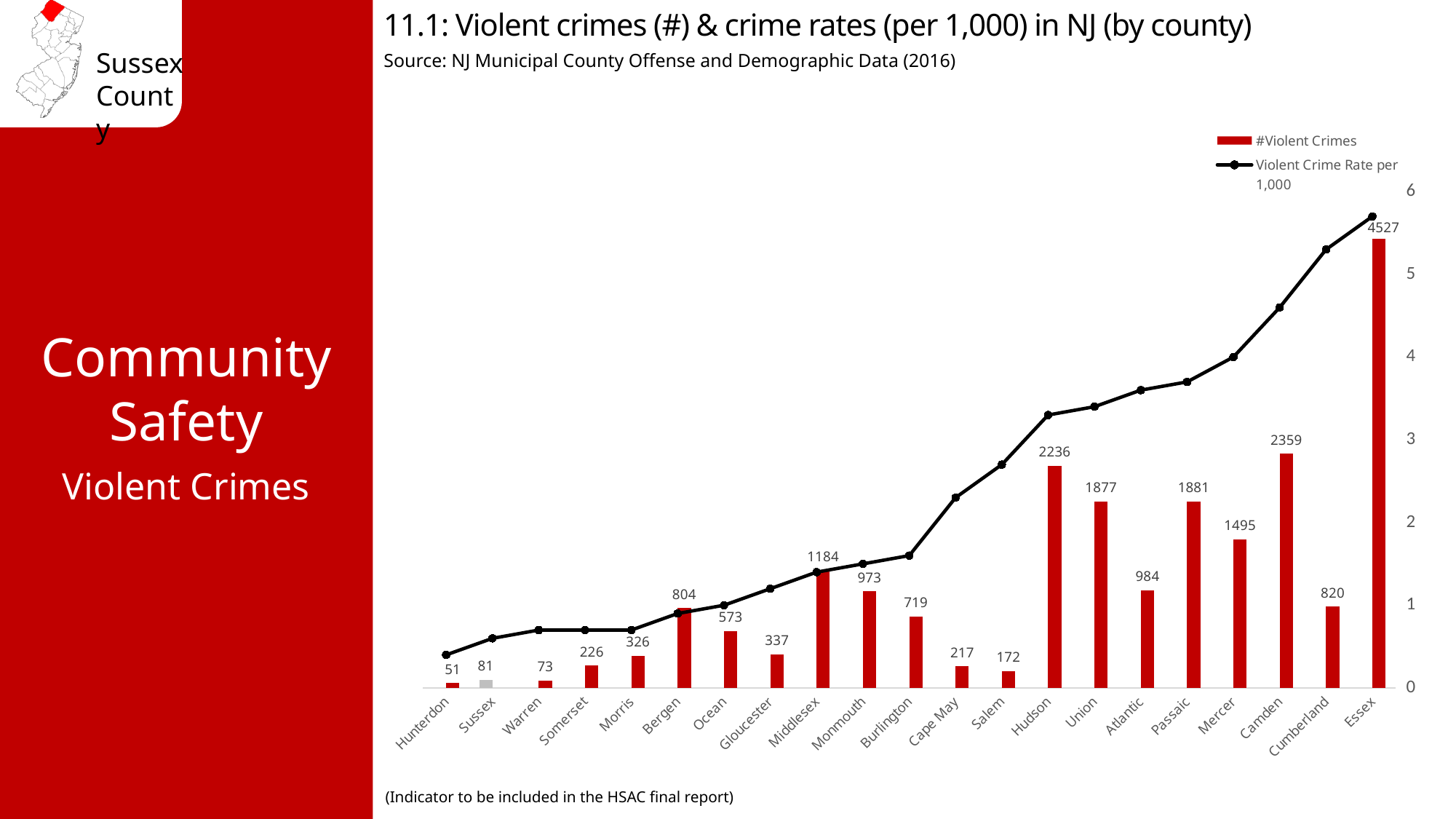
How many series does the legend list? 2 What is the number of violent crimes for Essex? 4527 Which county has more violent crimes, Monmouth or Burlington? Monmouth Which county has the lowest number of violent crimes? Hunterdon What is the number of violent crimes for Sussex? 81 Does the violent crime rate per 1,000 line rise or fall from left to right across the counties? rises How many counties are shown on the x axis? 21 Is the violent crime rate per 1,000 for Hunterdon greater or less than 1? less Which county has the highest number of violent crimes? Essex What is the number of violent crimes for Middlesex? 1184 Is the violent crime rate per 1,000 for Essex greater or less than 5? greater What is the difference in the number of violent crimes between Camden and Hudson? 123